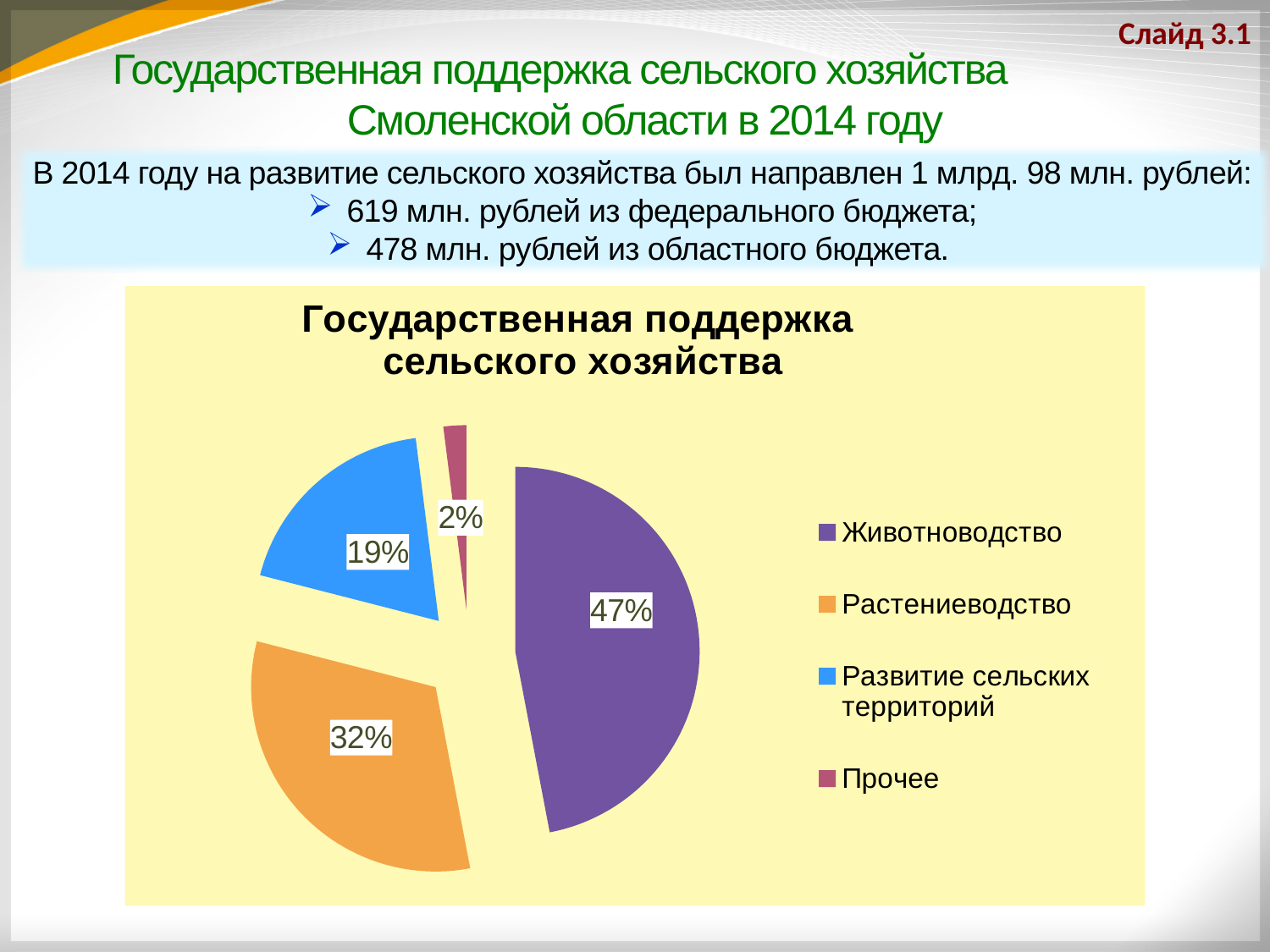
What kind of chart is shown on the slide? pie chart What colour is the slice for Развитие сельских территорий? blue How many categories does the pie chart show? 4 What share of the pie does Развитие сельских территорий take? 19% Which category has the smallest slice of the pie? Прочее What is the title of the chart? Государственная поддержка сельского хозяйства What is the difference in percentage points between Животноводство and Растениеводство? 15% What share of the pie does Прочее take? 2% What share of the pie does Растениеводство take? 32% Which category has the largest slice of the pie? Животноводство Which is larger, the share for Растениеводство or the share for Развитие сельских территорий? Растениеводство